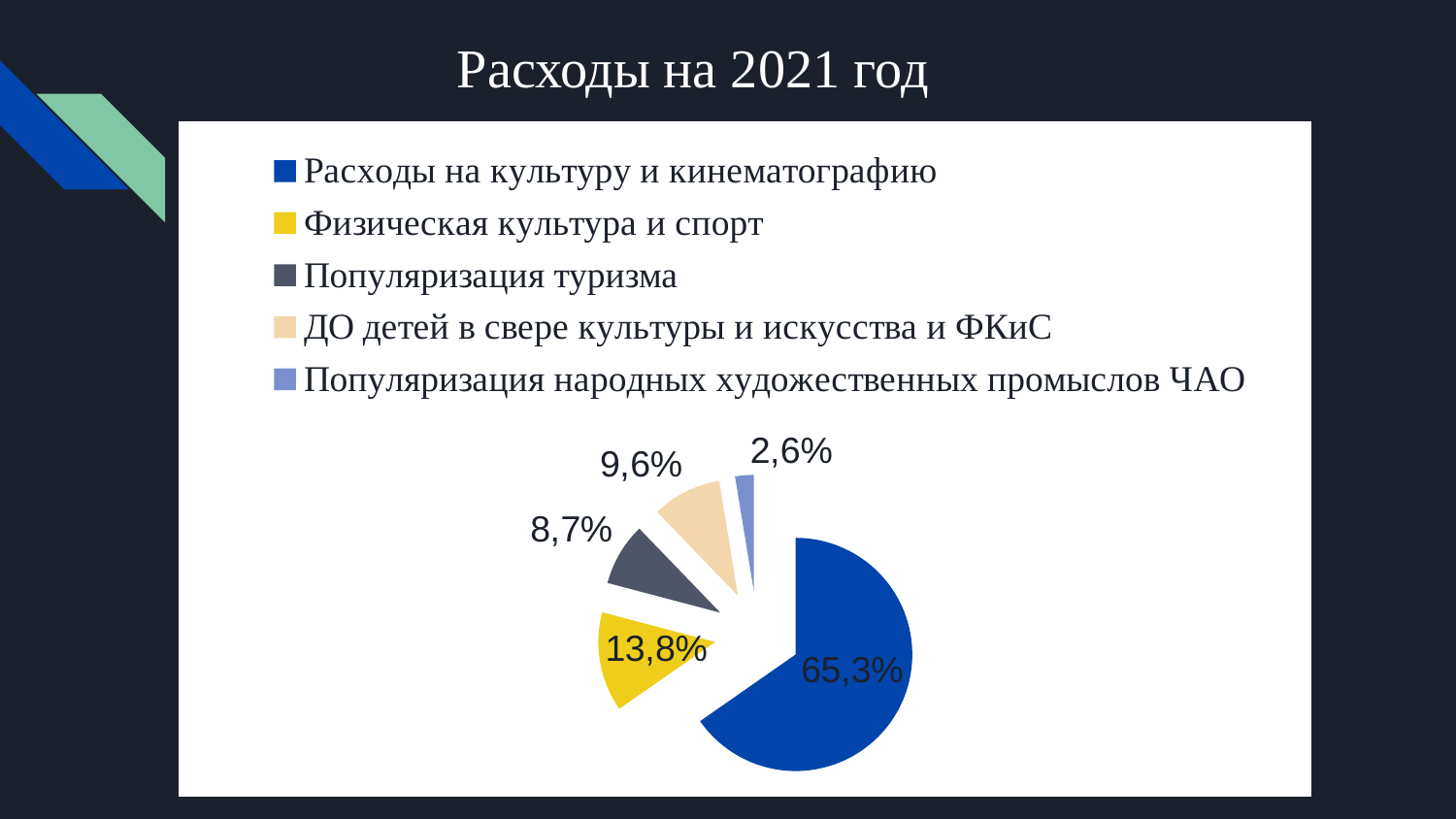
What share of the pie does "Популяризация народных художественных промыслов ЧАО" have? 2,6% What is the title of the slide containing the pie chart? Расходы на 2021 год How many slices does the pie chart have? 5 What share of the pie does "Физическая культура и спорт" have? 13,8% What share of the pie does "ДО детей в свере культуры и искусства и ФКиС" have? 9,6% What kind of chart is shown on the slide? Pie chart What share of the pie does "Популяризация туризма" have? 8,7% What is the difference in percentage points between the "Расходы на культуру и кинематографию" slice and the "Физическая культура и спорт" slice? 51,5 Which category has the smallest slice of the pie? Популяризация народных художественных промыслов ЧАО Which is larger: the slice for "Популяризация туризма" or the slice for "ДО детей в свере культуры и искусства и ФКиС"? ДО детей в свере культуры и искусства и ФКиС What share of the pie does "Расходы на культуру и кинематографию" have? 65,3% Which category has the largest slice of the pie? Расходы на культуру и кинематографию